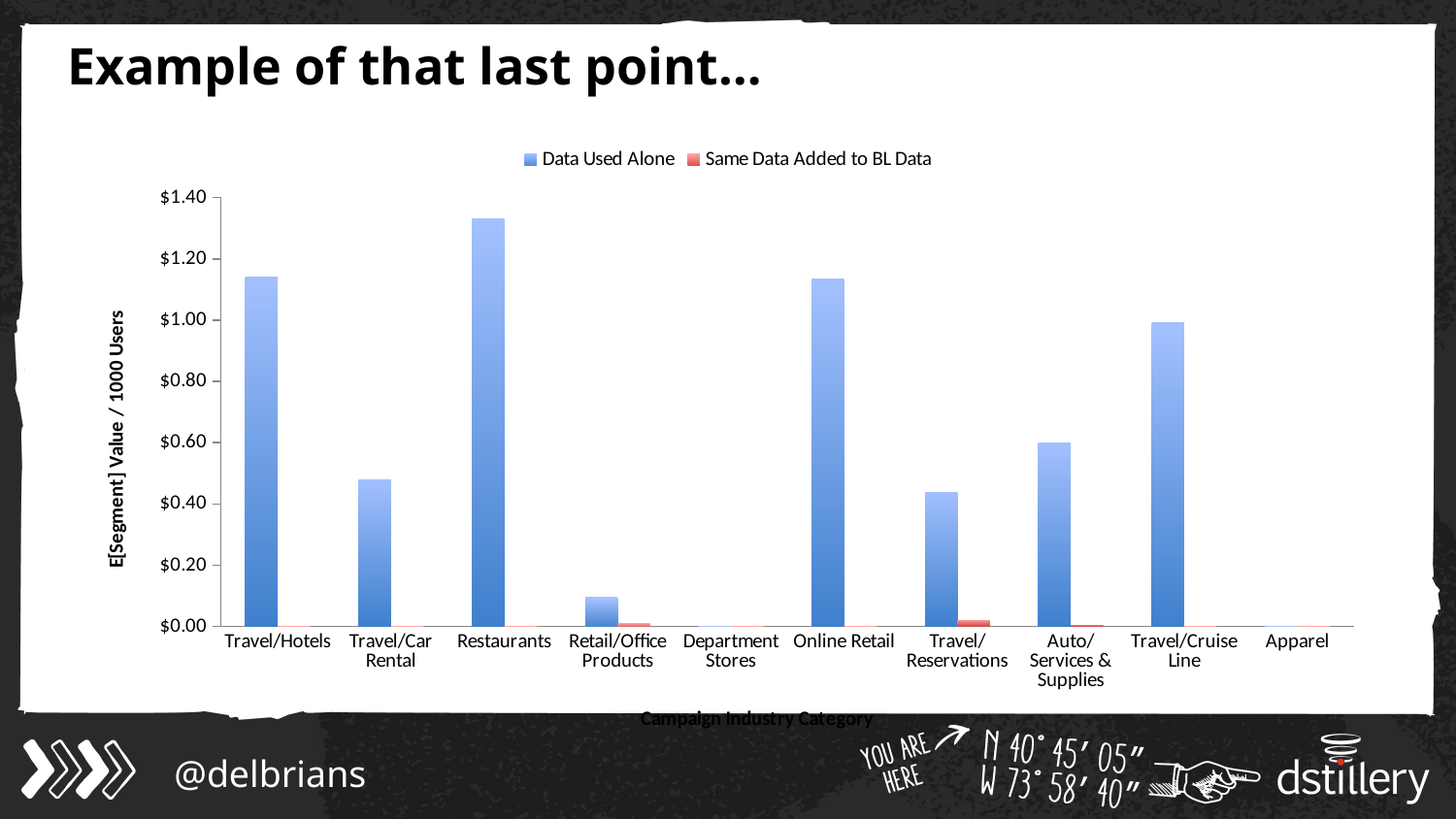
Is the Data Used Alone value for Travel/Cruise Line greater or less than $0.80? greater Is the Data Used Alone value for Retail/Office Products greater or less than $0.20? less How many series does the legend list? 2 Which has the larger Data Used Alone value, Restaurants or Travel/Hotels? Restaurants What kind of chart is shown on the slide? bar chart How many campaign industry categories are shown on the x axis? 10 Is the Data Used Alone value for Online Retail greater or less than $1.00? greater Which category has the highest value for Data Used Alone? Restaurants Which has the larger Data Used Alone value, Auto/Services & Supplies or Travel/Car Rental? Auto/Services & Supplies What is the title of the vertical axis? E[Segment] Value / 1000 Users